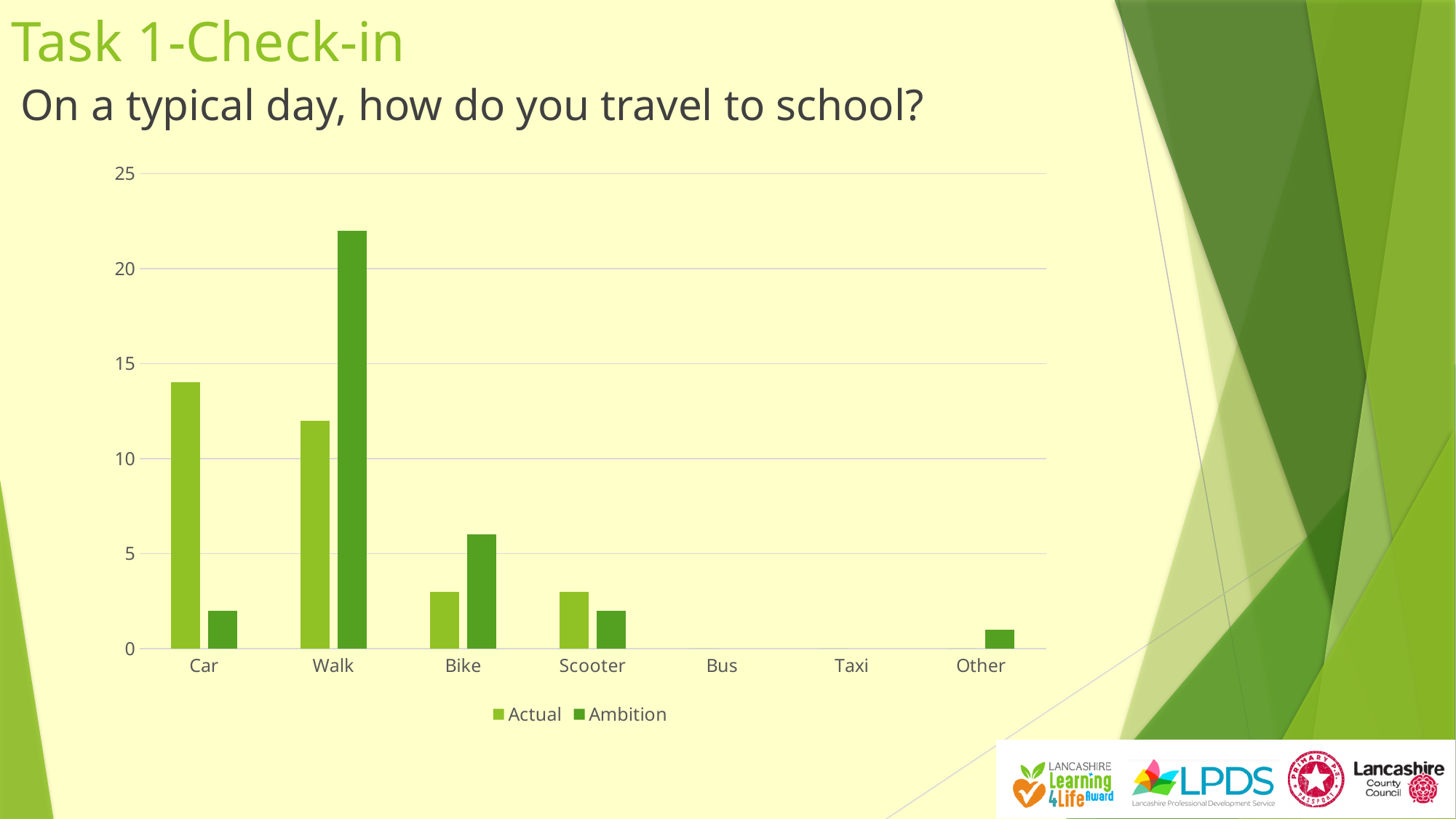
Is the Actual value for Car greater or less than 10? greater What are the two series named in the chart's legend? Actual and Ambition Which is larger, the Actual value for Car or the Actual value for Walk? Car Which category has the highest Actual value? Car How many series does the chart's legend list? 2 What kind of chart is shown on the slide? bar chart Which category has the highest Ambition value? Walk How many travel categories are shown on the x axis of the chart? 7 Is the Actual value for Scooter greater or less than 5? less Is the Ambition value for Walk greater or less than 20? greater Which is larger, the Ambition value for Bike or the Ambition value for Scooter? Bike